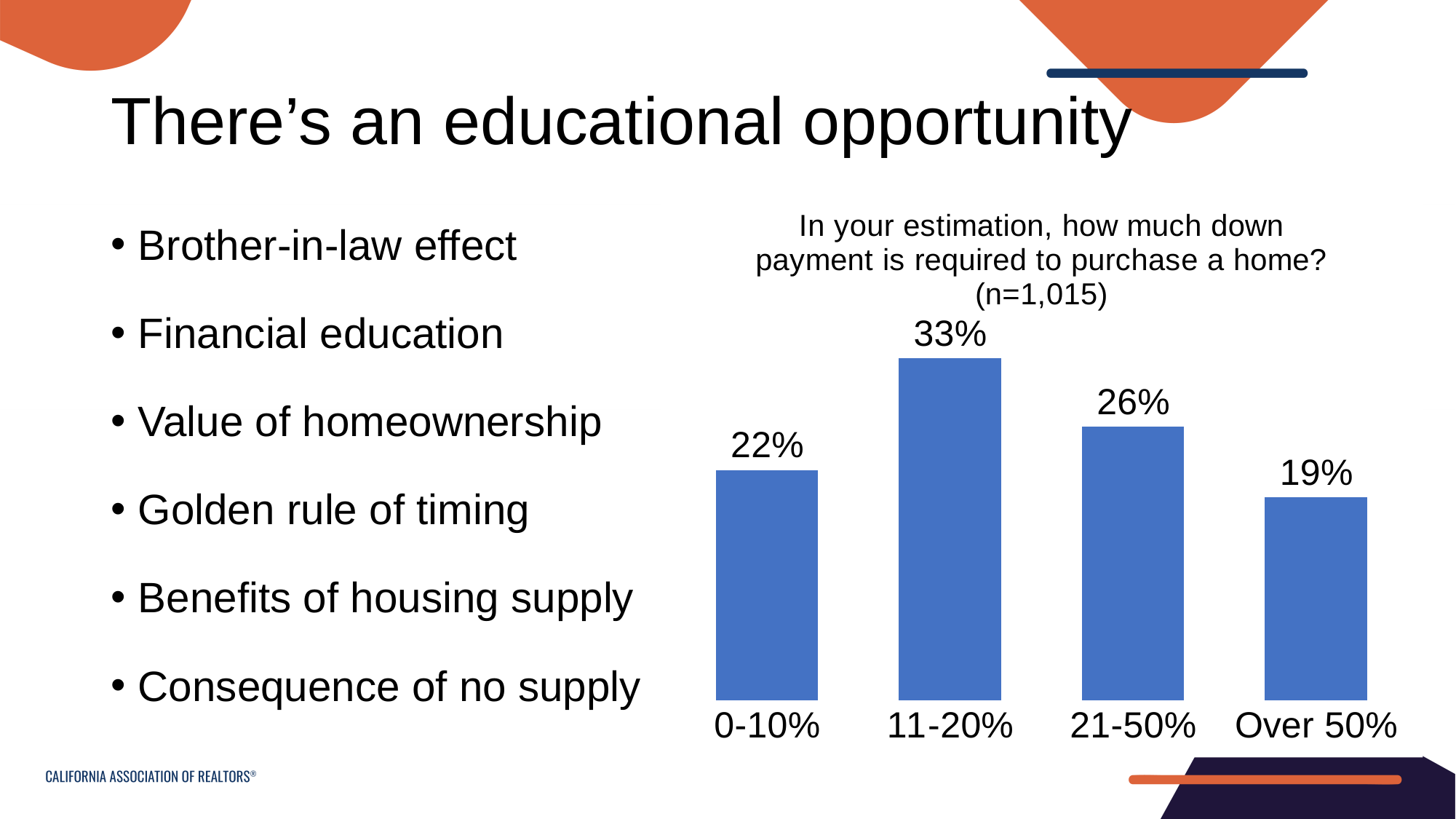
What is the value shown for the 21-50% category? 26% What is the value shown for the 0-10% category? 22% Which down payment category has the lowest share of respondents? Over 50% Which down payment category has the highest share of respondents? 11-20% What is the value shown for the Over 50% category? 19% What kind of chart is shown on the slide? Bar chart How many down payment categories are shown in the chart? 4 What is the difference between the values for 11-20% and Over 50%? 14% What is the difference between the values for 21-50% and 0-10%? 4% What sample size (n) is stated in the chart title? n=1,015 Which is larger, the value for 0-10% or the value for 21-50%? 21-50% What percentage of respondents estimated a down payment of 11-20% is required? 33%